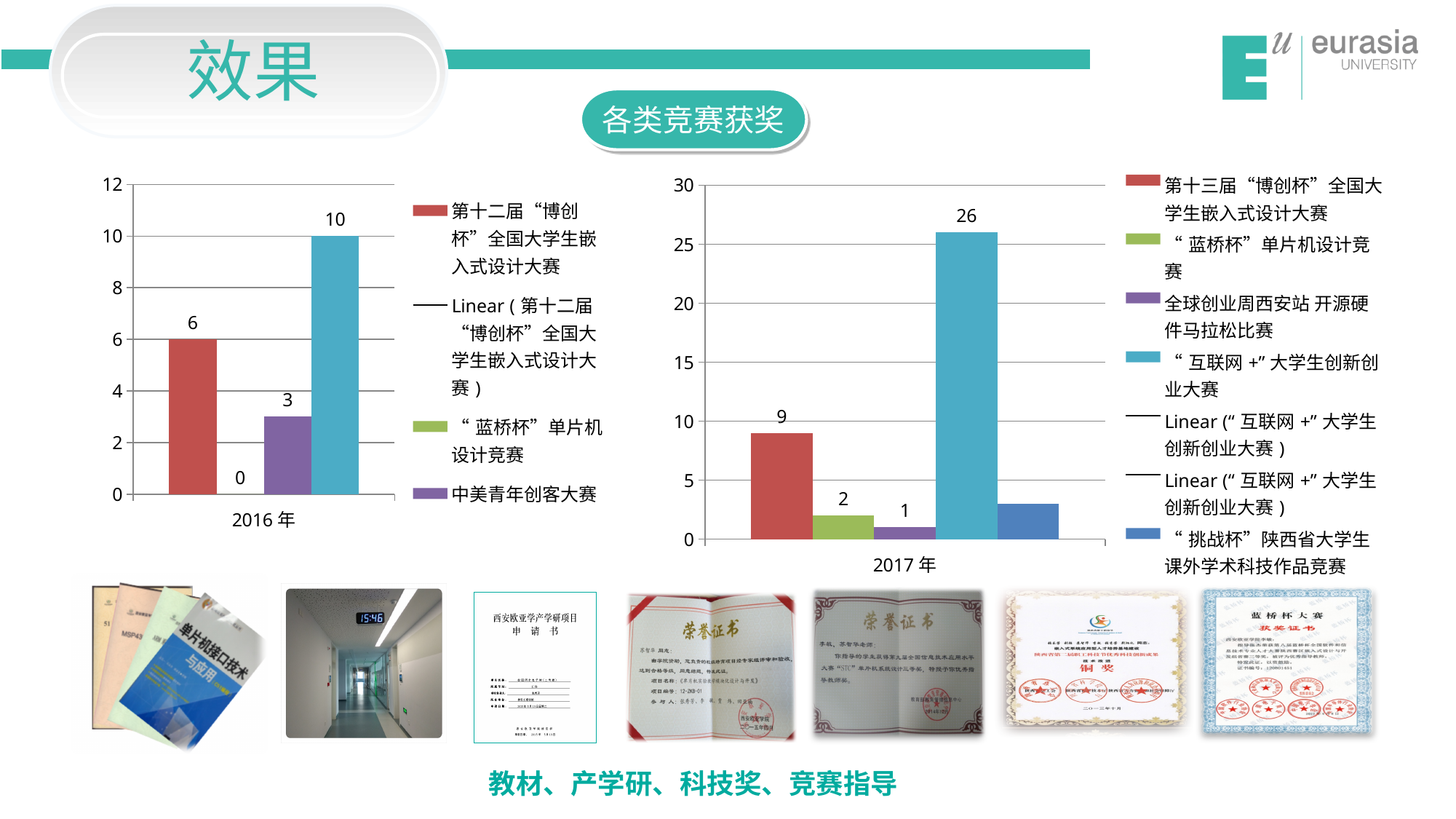
In the 2017年 chart on the right, what is the value for 全球创业周西安站 开源硬件马拉松比赛? 1 What kind of chart is the 2017年 chart on the right? bar chart In the 2017年 chart on the right, what is the difference between the value for “互联网+”大学生创新创业大赛 and the value for 第十三届“博创杯”全国大学生嵌入式设计大赛? 17 In the 2016年 chart on the left, what is the value for “蓝桥杯”单片机设计竞赛? 0 In the 2017年 chart on the right, is the value for “挑战杯”陕西省大学生课外学术科技作品竞赛 greater or less than 5? less In the 2016年 chart on the left, how much larger is the value for 第十二届“博创杯”全国大学生嵌入式设计大赛 than the value for 中美青年创客大赛? 3 In the 2016年 chart on the left, what is the value for 中美青年创客大赛? 3 In the 2017年 chart on the right, what is the value for “互联网+”大学生创新创业大赛? 26 In the 2017年 chart on the right, which competition has the highest value? “互联网+”大学生创新创业大赛 In the 2016年 chart on the left, what is the value for 第十二届“博创杯”全国大学生嵌入式设计大赛? 6 In the 2017年 chart on the right, what is the value for 第十三届“博创杯”全国大学生嵌入式设计大赛? 9 In the 2016年 chart on the left, what is the highest value labelled on any bar? 10